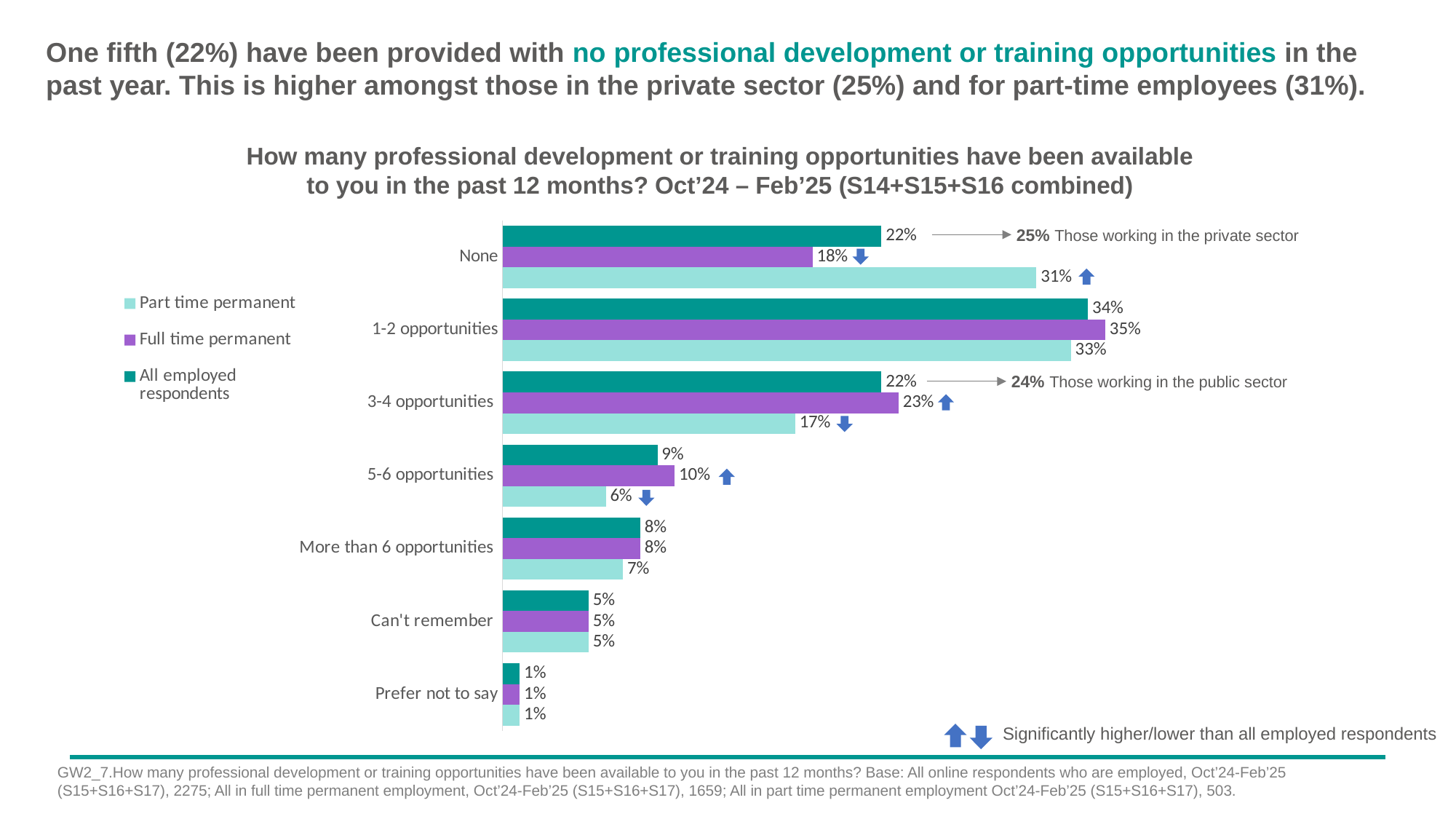
How many series does the legend list? 3 What is the value for part time permanent employees in the 'None' category? 31% What is the difference between the part time permanent and full time permanent values in the 'None' category? 13% How many response categories are shown on the chart? 7 Which category has the highest value for full time permanent employees? 1-2 opportunities What is the value for full time permanent employees for '3-4 opportunities'? 23% Which series is shown in the darkest teal colour? All employed respondents What kind of chart is shown on the slide? Bar chart What percentage of all employed respondents said they had been provided with no professional development or training opportunities? 22% For '5-6 opportunities', which is larger: the full time permanent value or the part time permanent value? Full time permanent According to the annotation, what percentage of those working in the private sector had no opportunities? 25% Which category has the lowest value for all employed respondents? Prefer not to say